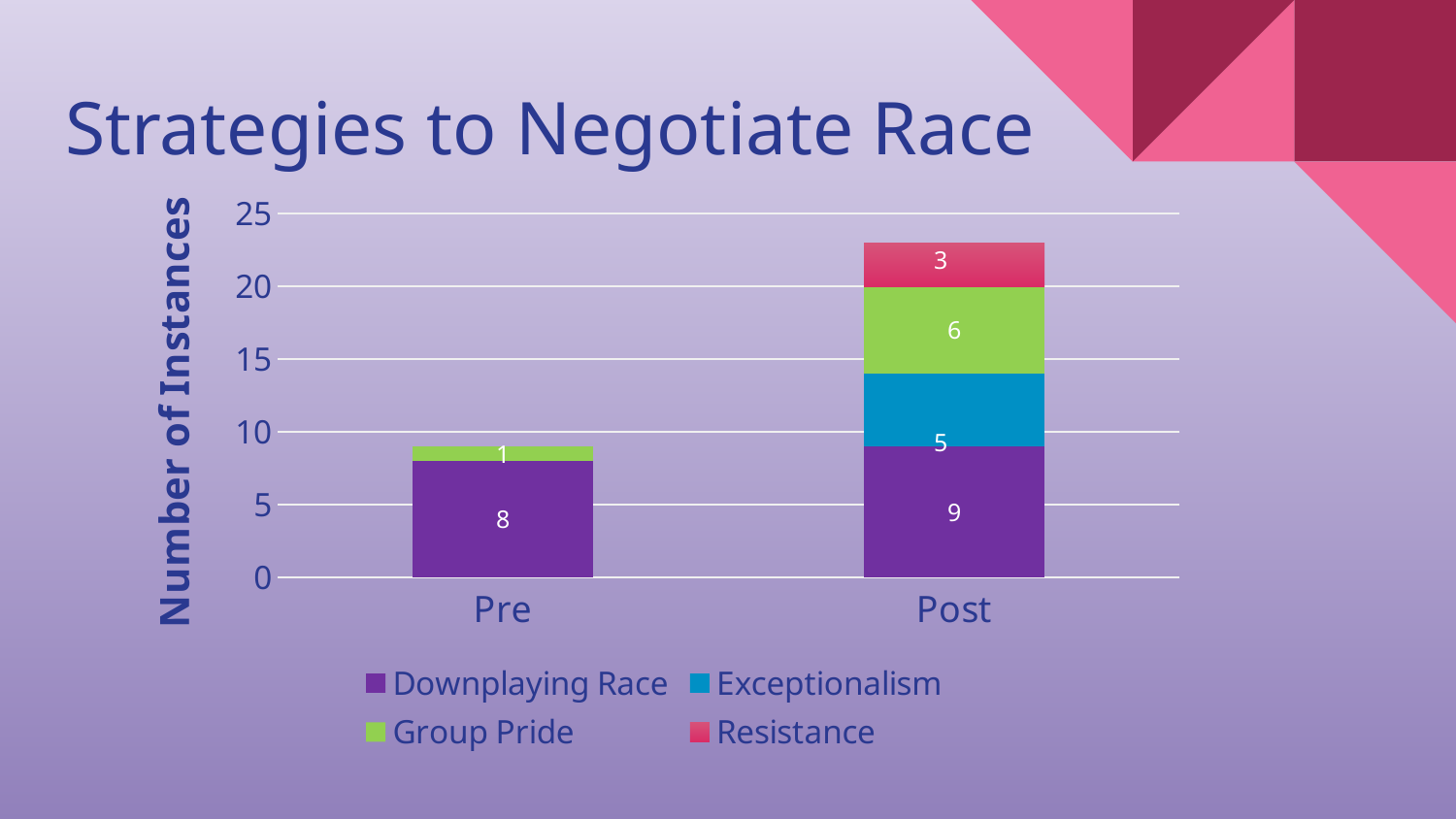
Which category has the larger Downplaying Race value, Pre or Post? Post What is the value for Resistance in the Post bar? 3 What kind of chart is shown on the slide? Stacked bar chart What is the value for Exceptionalism in the Post bar? 5 How many categories are shown on the x axis? 2 How many series does the legend list? 4 What is the total of the Pre stacked bar? 9 What is the difference between the Group Pride values for Post and Pre? 5 What is the label of the y axis? Number of Instances What is the value for Downplaying Race in the Pre bar? 8 What is the value for Group Pride in the Post bar? 6 What is the total of the Post stacked bar? 23